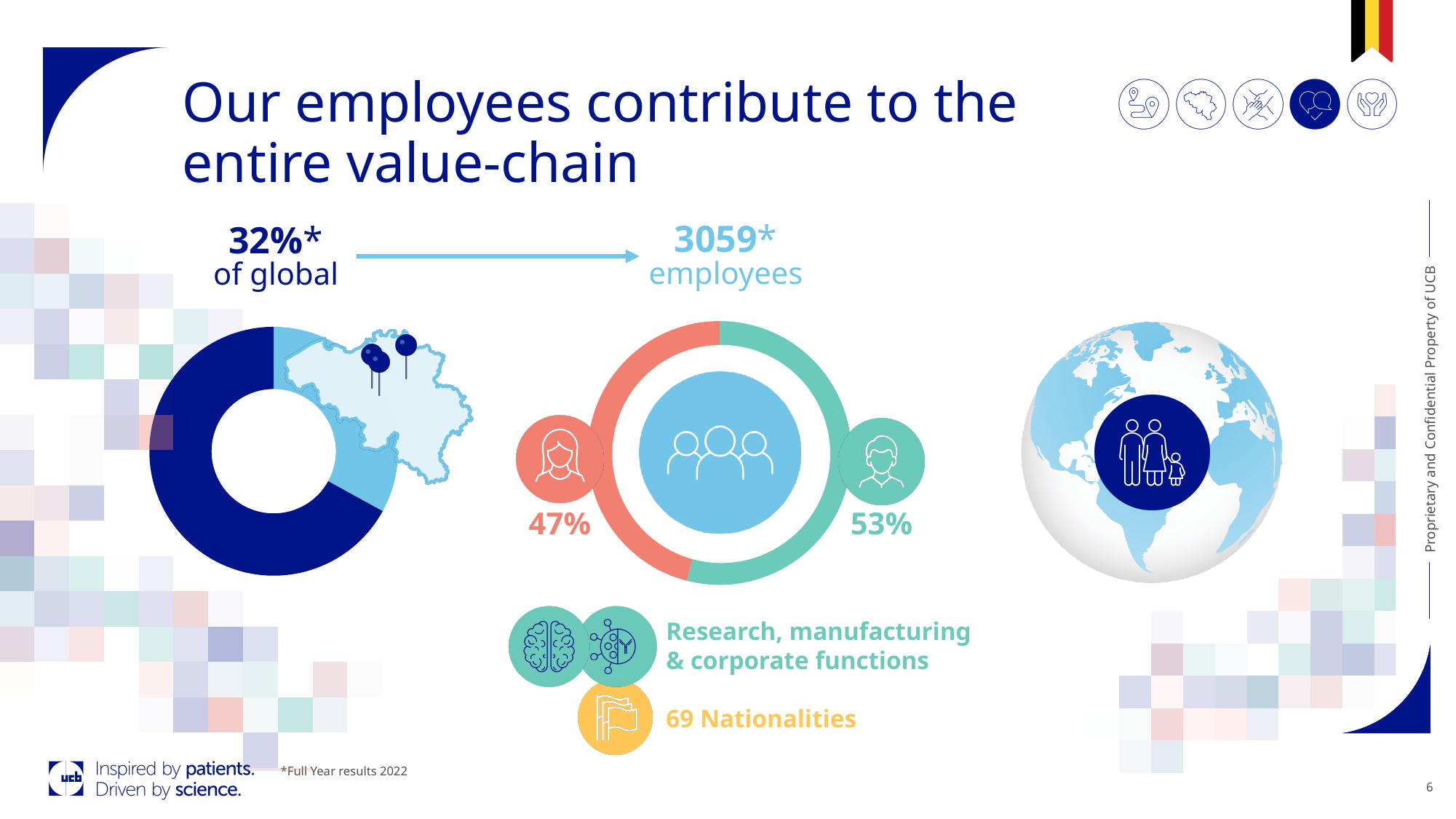
In the left donut chart, how many employees does the 32% share correspond to? 3059 In the middle ring chart, what is the difference in percentage points between the men's share and the women's share? 6 percentage points How many segments does the middle ring chart have? 2 In the middle ring chart, what percentage is shown next to the male icon? 53% In the middle ring chart, what do the 47% and 53% segments add up to? 100% In the middle ring chart, what percentage is shown next to the female icon? 47% In the left donut chart, which segment is larger, the dark blue one or the light blue one? Dark blue What type of chart is shown on the left of the slide, next to the map of Belgium? Donut chart In the left donut chart, what percentage of global employees does the light blue segment represent? 32% In the left donut chart, is the light blue segment greater or less than 50% of the ring? less In the middle ring chart, what colour is the segment representing 53%? Green In the middle ring chart, which group has the larger share, women or men? Men